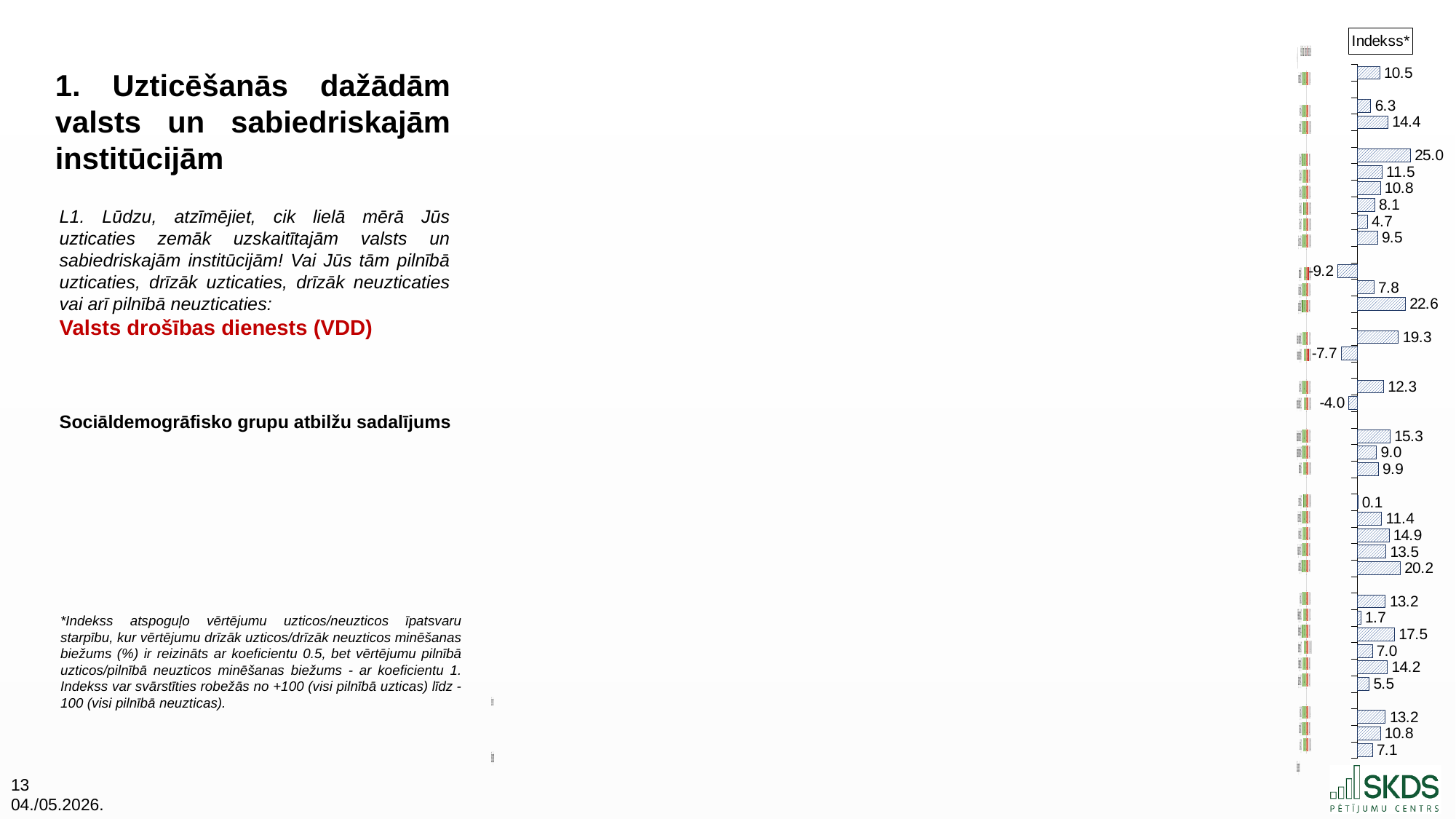
In the "Indekss*" chart, what is the difference between the highest value (25.0) and the lowest value (-9.2)? 34.2 In the "Indekss*" chart, what is the smallest positive value shown? 0.1 In the "Indekss*" chart, what is the highest value shown? 25.0 In the "Indekss*" chart, what is the value of the topmost bar? 10.5 In the "Indekss*" chart, which is larger: the value 22.6 or the value 19.3? 22.6 In the "Indekss*" chart, what is the value of the bottommost bar? 7.1 What is the title shown above the chart on the right of the slide? Indekss* In the "Indekss*" chart, how many bars have a negative value? 3 In the "Indekss*" chart, how many bars have a value above 20? 3 In the "Indekss*" chart, are the bars drawn horizontally or vertically? horizontally What kind of chart is the "Indekss*" chart on the right of the slide? bar chart In the "Indekss*" chart, what is the lowest value shown? -9.2